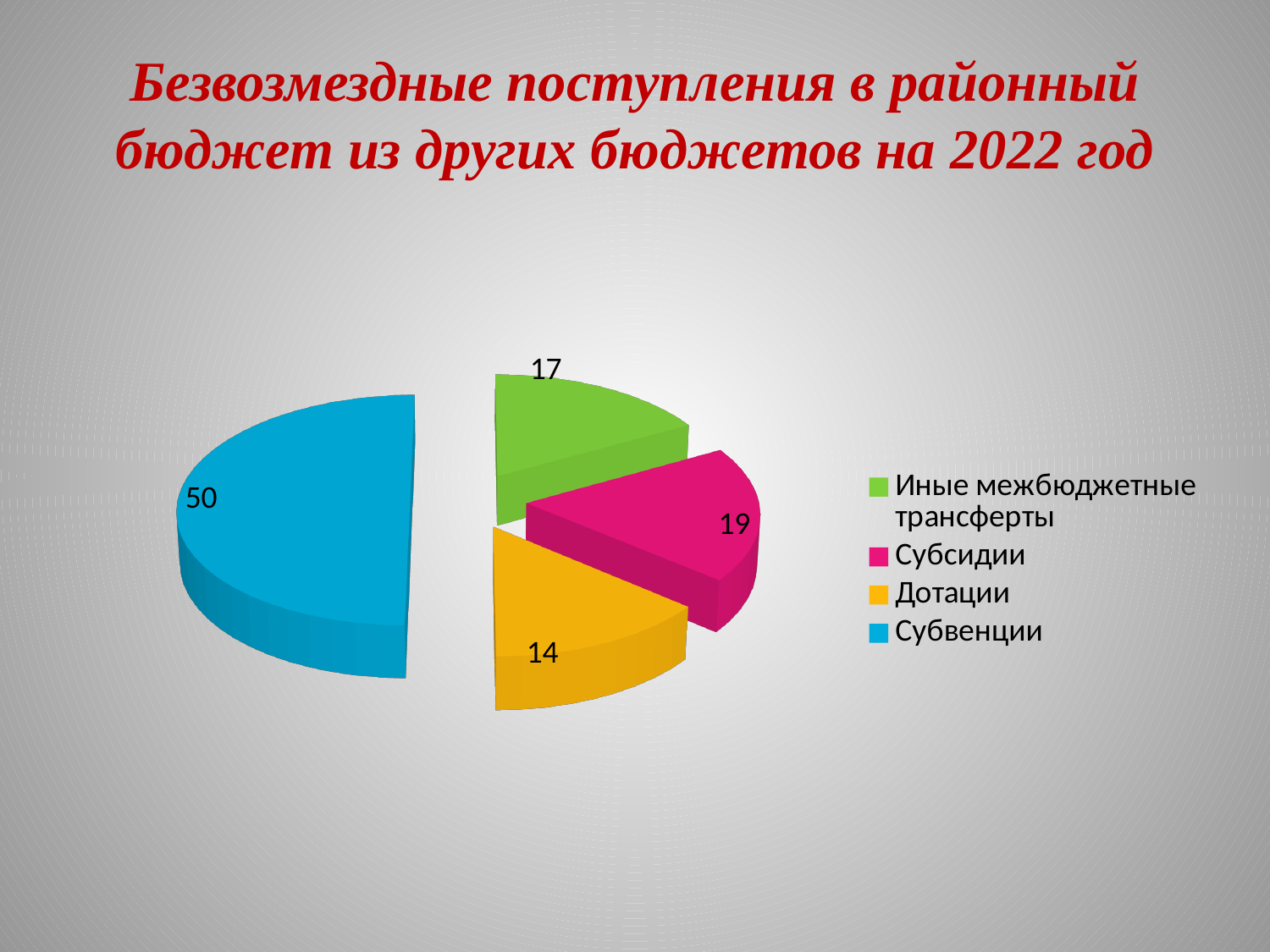
What is the value for Субвенции? 50 What share of the pie does Субвенции represent? 50% What is the value for Дотации? 14 What colour is the slice for Дотации? Yellow Which is larger, the value for Субсидии or the value for Иные межбюджетные трансферты? Субсидии What is the value for Субсидии? 19 Which category has the smallest slice? Дотации Which category has the largest slice? Субвенции What kind of chart is shown on the slide? Pie chart What is the value for Иные межбюджетные трансферты? 17 What is the difference between the values for Субвенции and Субсидии? 31 How many slices does the pie chart have? 4